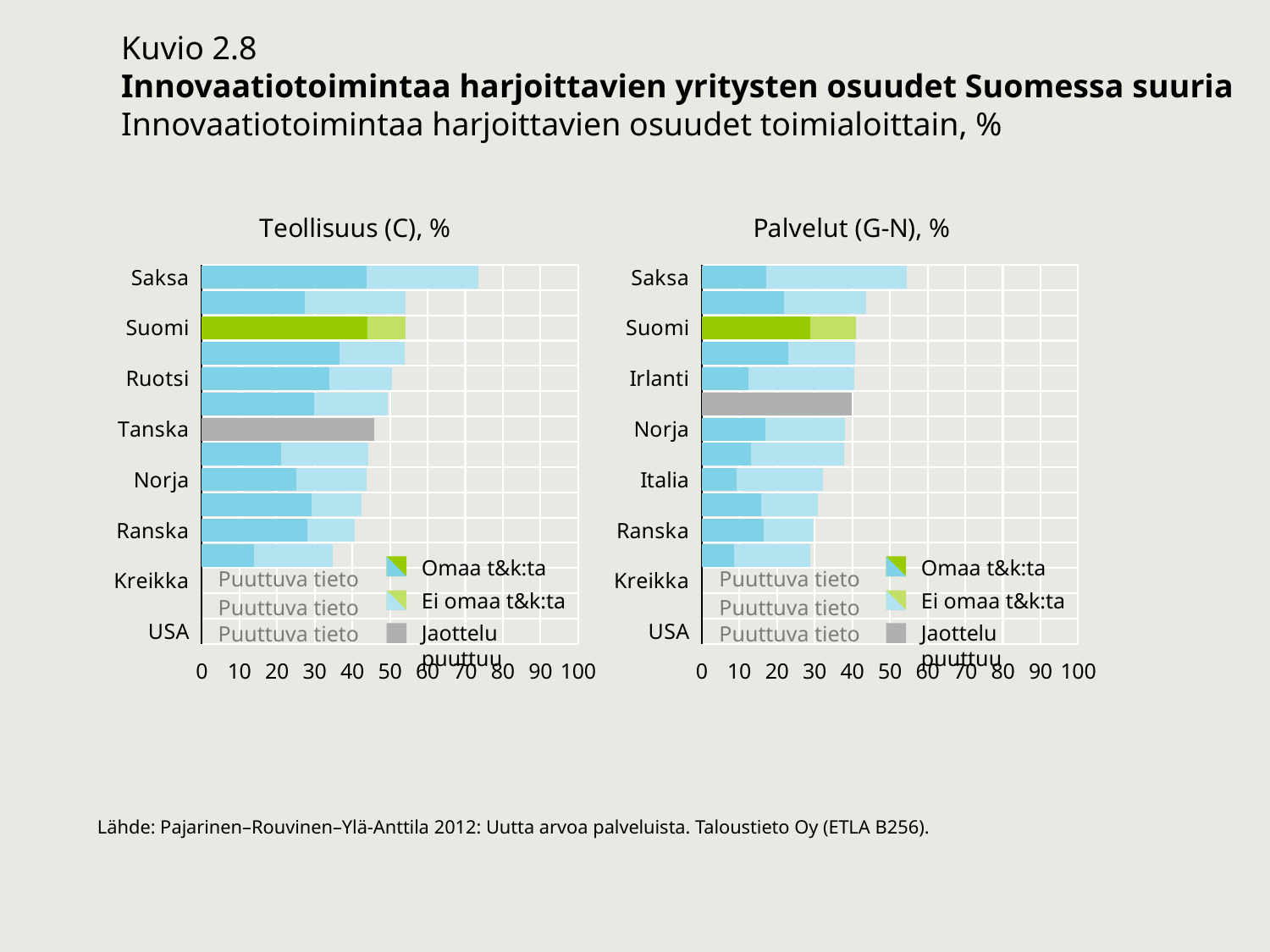
In the Teollisuus (C), % chart, which has the larger total bar, Saksa or Suomi? Saksa What is the title of the right-hand chart? Palvelut (G-N), % In the Teollisuus (C), % chart, is the total value for Saksa greater or less than 60? greater In the Palvelut (G-N), % chart, which labelled country has the longest total bar? Saksa In the Palvelut (G-N), % chart, which has the larger total bar, Saksa or Ranska? Saksa In the Teollisuus (C), % chart, is the value for Tanska greater or less than 50? less How many series does the legend of the Palvelut (G-N), % chart list? 3 In the Palvelut (G-N), % chart, is the total value for Saksa greater or less than 40? greater What kind of chart is the Teollisuus (C), % chart? bar chart In the Teollisuus (C), % chart, which country's bar is highlighted in green? Suomi In the Teollisuus (C), % chart, which labelled country has the longest total bar? Saksa